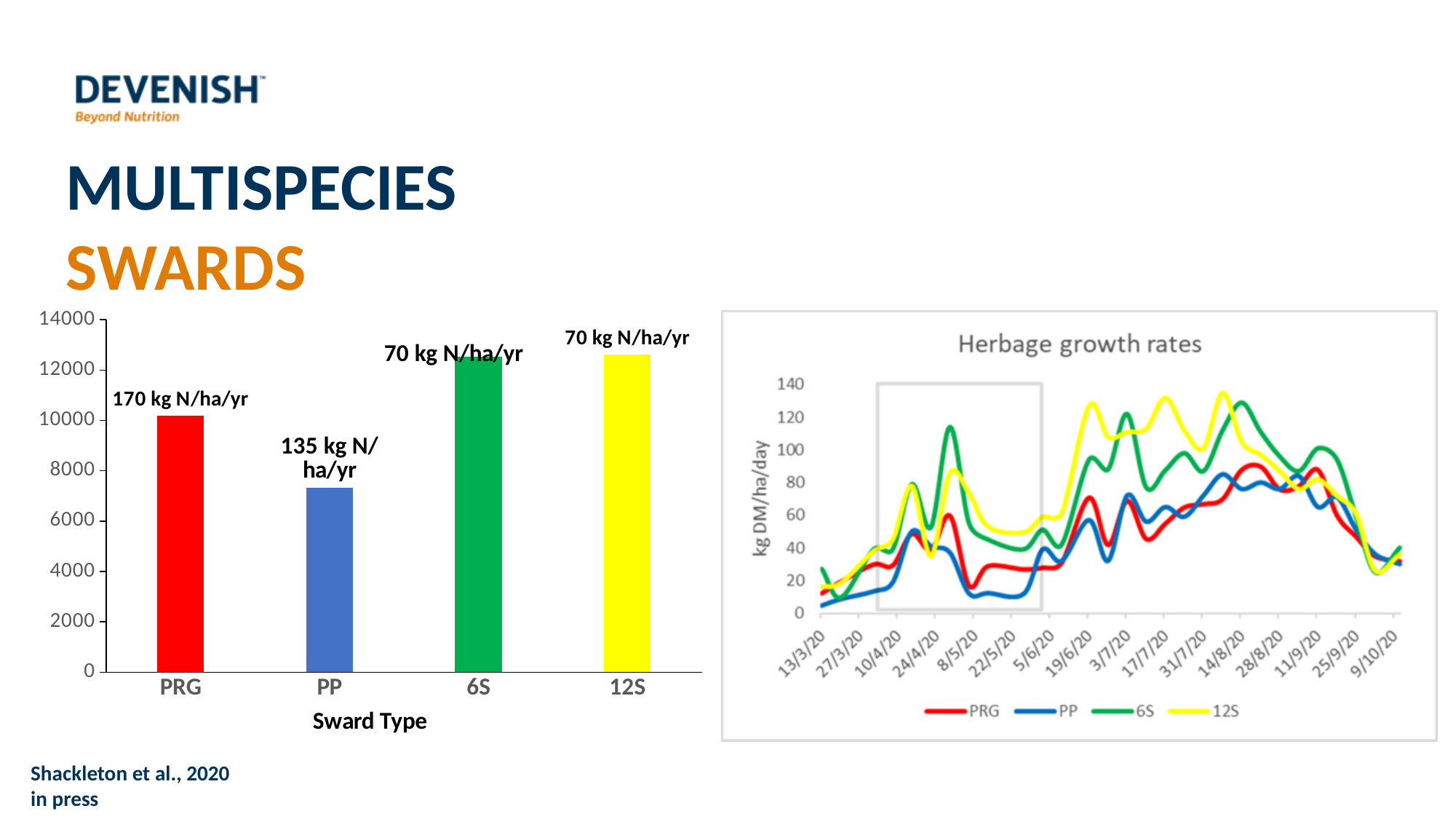
On the left bar chart (Sward Type), what kind of chart is shown? bar chart On the left bar chart (Sward Type), what colour is the 12S bar? yellow On the left bar chart (Sward Type), which is larger, the value for PRG or the value for PP? PRG On the left bar chart (Sward Type), which sward type has the lowest bar? PP On the left bar chart (Sward Type), how many sward types are plotted? 4 On the Herbage growth rates chart, how many series does the legend list? 4 On the left bar chart (Sward Type), is the value for 6S greater or less than 12000? greater On the left bar chart (Sward Type), is the value for PP greater or less than 8000? less On the Herbage growth rates chart, is the value for PP on 8/5/20 greater or less than 20? less On the left bar chart (Sward Type), what nitrogen application rate is labelled above the PRG bar? 170 kg N/ha/yr